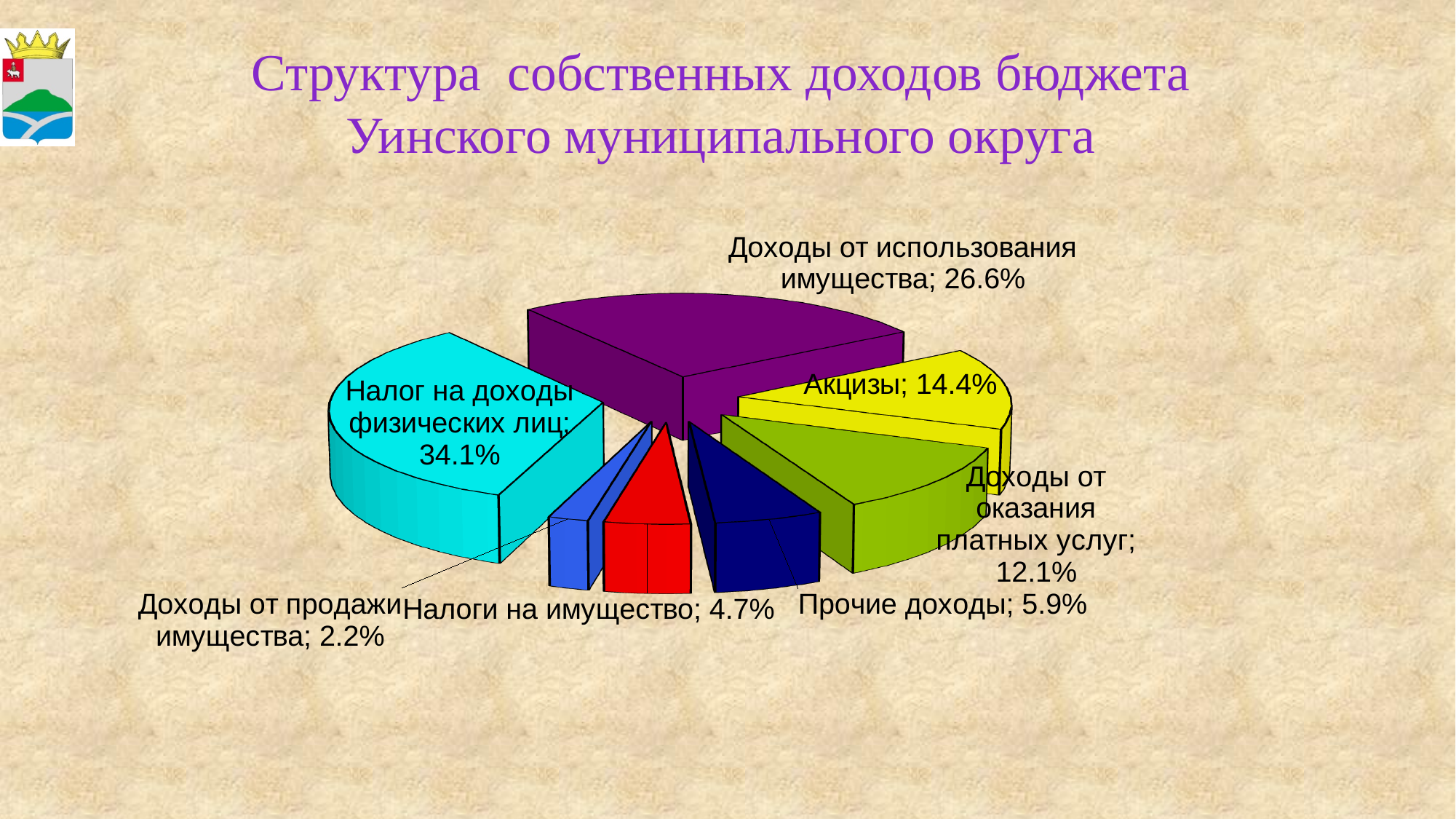
Which category has the smallest share of the pie? Доходы от продажи имущества Which is larger: "Прочие доходы" or "Налоги на имущество"? Прочие доходы How many slices does the pie chart have? 7 What is the difference in percentage points between "Налог на доходы физических лиц" and "Доходы от использования имущества"? 7.5 What percentage is shown for "Доходы от оказания платных услуг"? 12.1% What is the title of the slide containing the chart? Структура собственных доходов бюджета Уинского муниципального округа What percentage is shown for "Доходы от продажи имущества"? 2.2% What is the combined share of "Акцизы" and "Доходы от оказания платных услуг"? 26.5% What percentage is shown for "Акцизы"? 14.4% What share of the budget's own revenues comes from "Налог на доходы физических лиц"? 34.1% Which category has the largest share of the pie? Налог на доходы физических лиц What kind of chart is shown on the slide? Pie chart